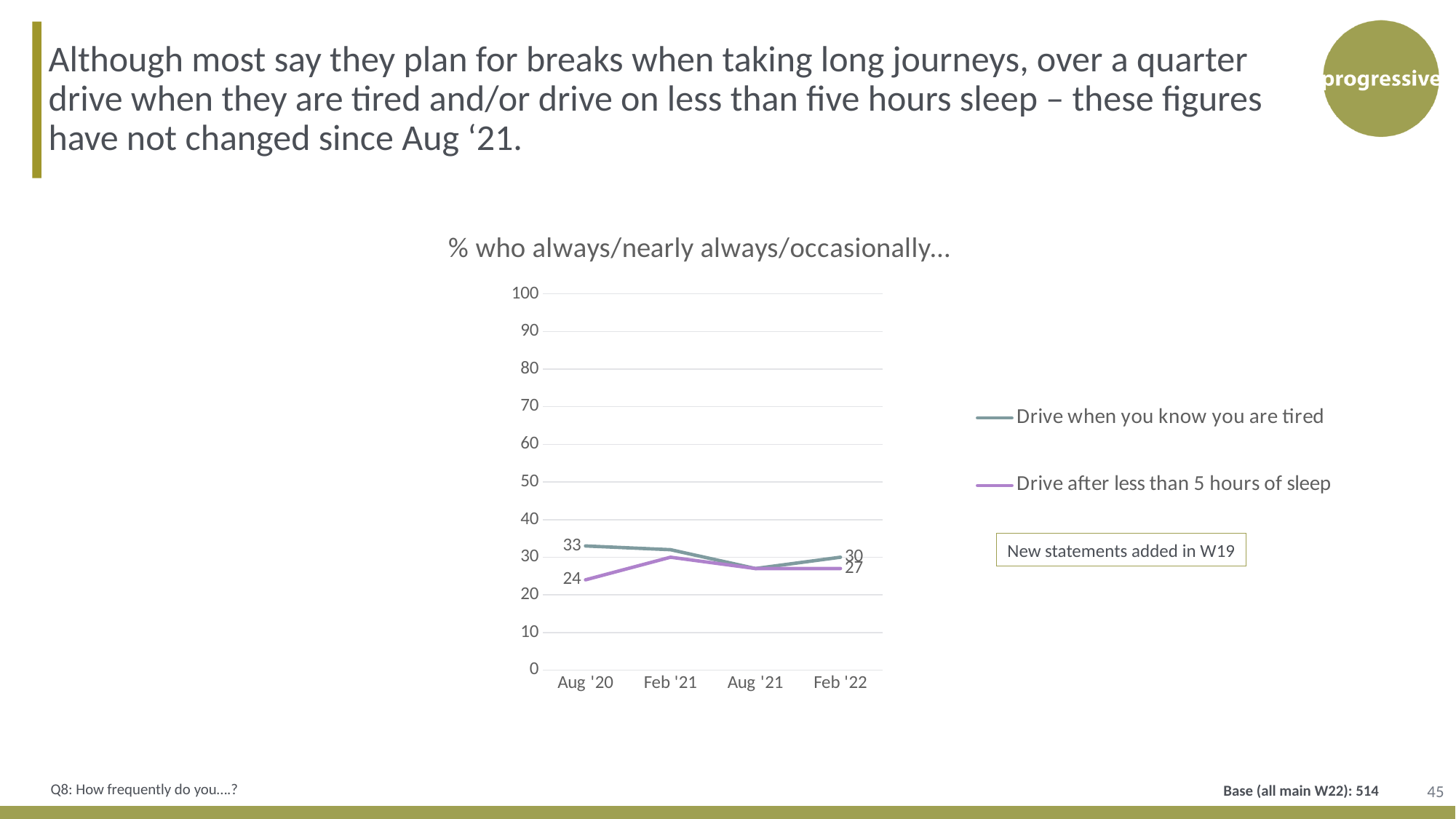
Is the value for 'Drive after less than 5 hours of sleep' in Aug '21 greater or less than 40? less What is the difference between the two series' values in Aug '20? 9 What is the value for 'Drive after less than 5 hours of sleep' in Aug '20? 24 What is the value for 'Drive after less than 5 hours of sleep' in Feb '22? 27 What is the title of the chart? % who always/nearly always/occasionally... What is the value for 'Drive when you know you are tired' in Aug '20? 33 How many time points are shown on the x axis? 4 What is the value for 'Drive when you know you are tired' in Feb '22? 30 What is the difference between the two series' values in Feb '22? 3 How many series does the legend list? 2 In Aug '20, which series has the higher value: 'Drive when you know you are tired' or 'Drive after less than 5 hours of sleep'? Drive when you know you are tired What kind of chart is shown on the slide? line chart